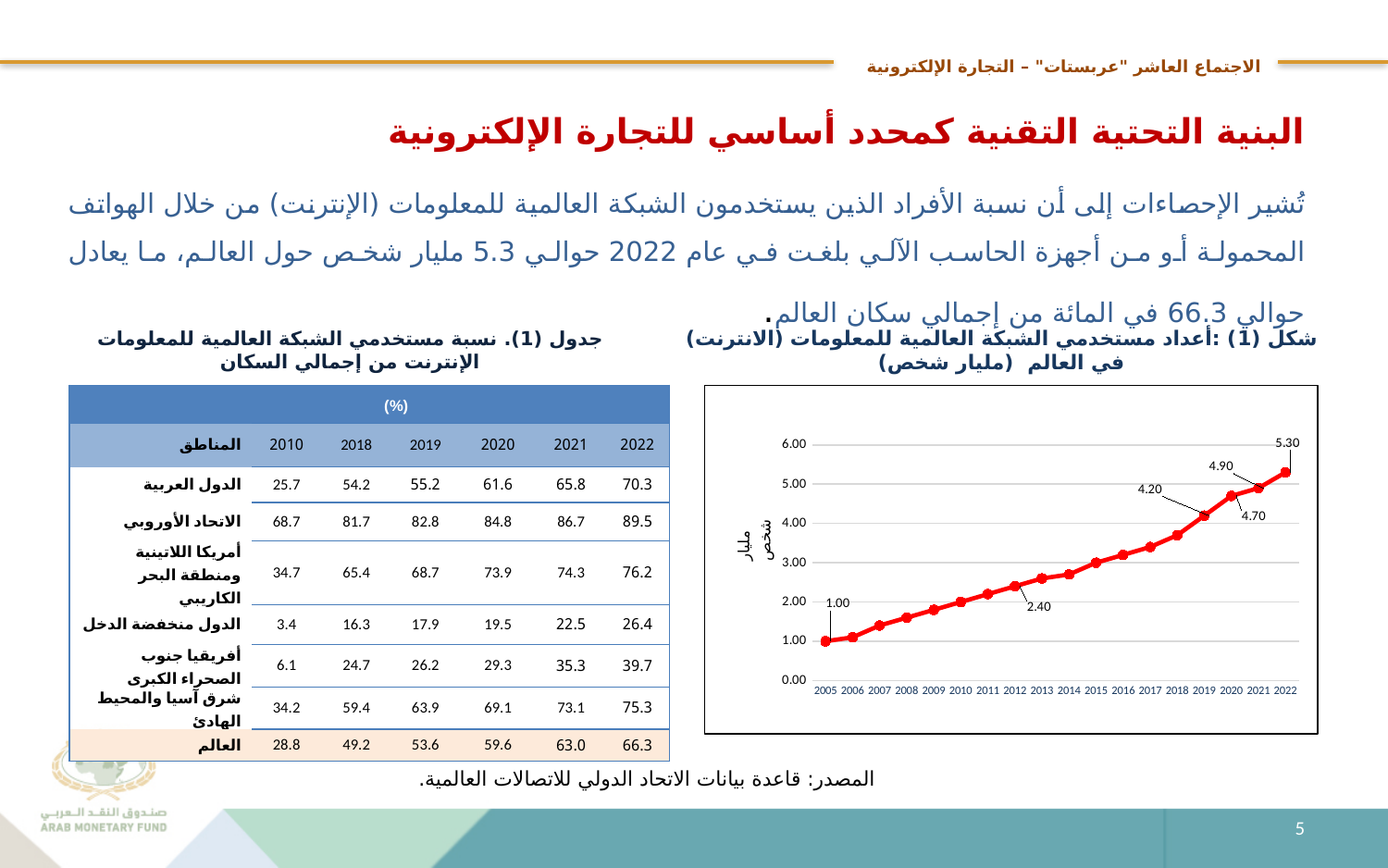
Do the values in the line chart rise or fall from 2005 to 2022? Rise Which year has the highest value in the line chart? 2022 What is the value for 2021 in the line chart? 4.90 What is the value for 2019 in the line chart? 4.20 In the line chart, is the value for 2008 greater or less than 2.00? less What is the value for 2020 in the line chart? 4.70 Which year has the lowest value in the line chart? 2005 What is the value for 2005 in the line chart? 1.00 What kind of chart is shown on the right of the slide? Line chart What is the value for 2022 in the line chart of internet users worldwide? 5.30 How many years are plotted on the x axis of the line chart? 18 By how much did the value in the line chart increase from 2005 to 2022? 4.30